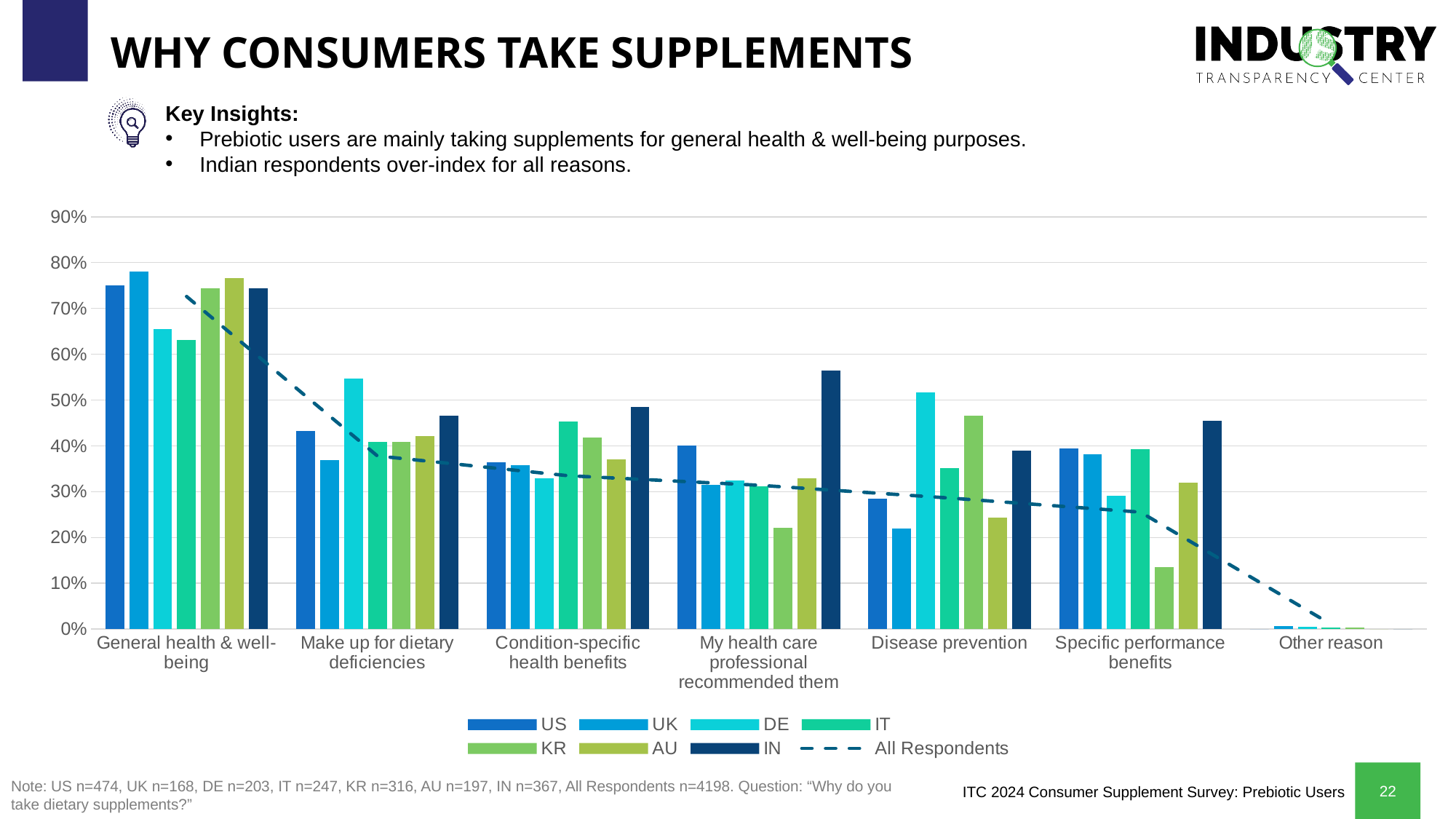
How many entries does the legend list? 8 Is the value for KR under 'Specific performance benefits' greater or less than 20%? less Which country has the lowest value for 'Make up for dietary deficiencies'? UK Which country has the highest value for 'Make up for dietary deficiencies'? DE What kind of chart is shown on the slide? combination bar and line chart Does the dashed 'All Respondents' line rise or fall from left to right across the categories? fall Which country has the highest value for 'My health care professional recommended them'? IN Which country has the lowest value for 'My health care professional recommended them'? KR Is the value for IN under 'My health care professional recommended them' greater or less than 50%? greater For 'Disease prevention', which is larger: the value for DE or the value for UK? DE Which country has the lowest value for 'Specific performance benefits'? KR How many reason categories are shown along the x axis? 7